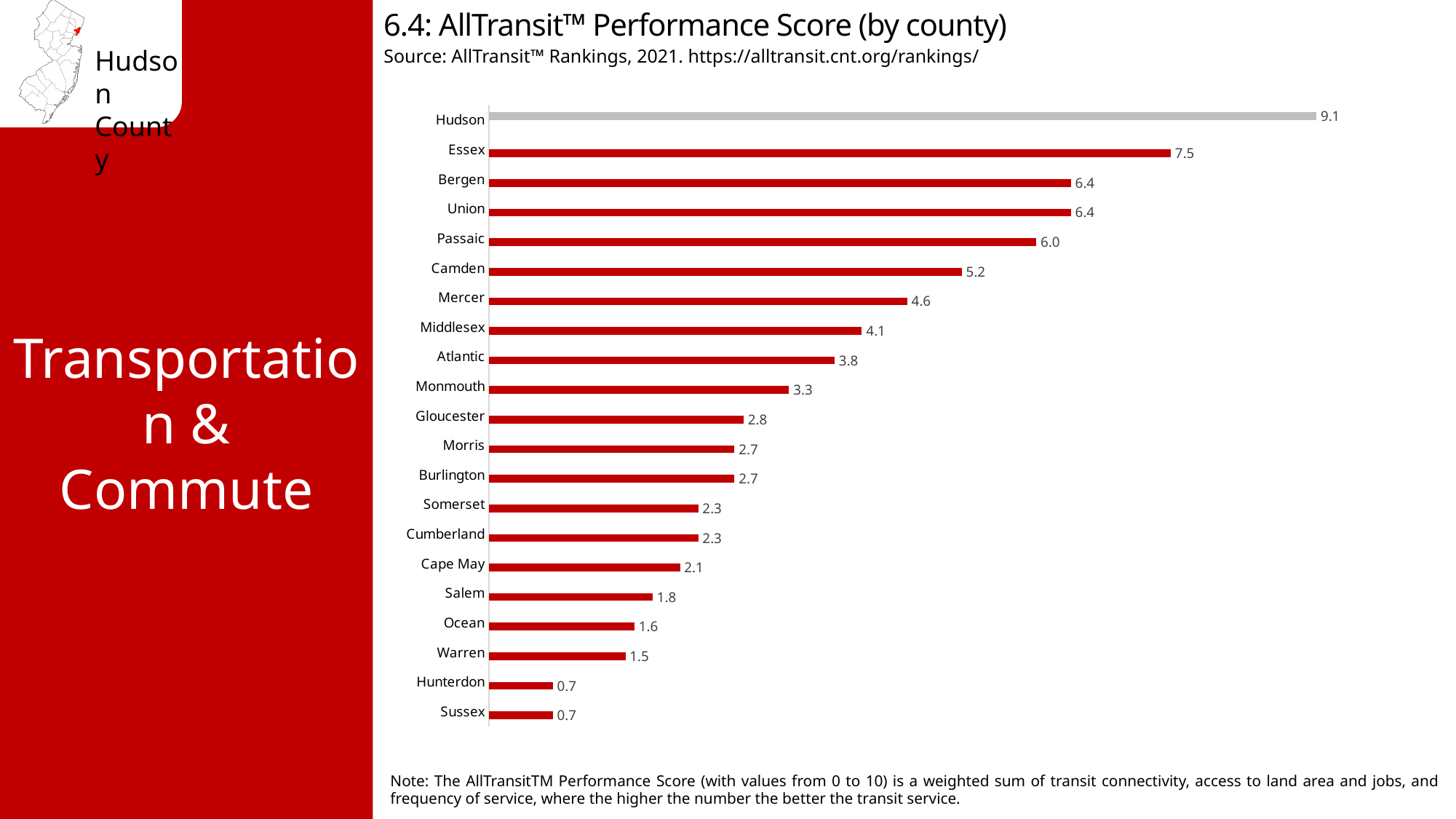
What is the AllTransit Performance Score for Hudson County? 9.1 What is the AllTransit Performance Score for Essex County? 7.5 What is the difference between the AllTransit Performance Scores of Hudson and Essex counties? 1.6 Which county has a higher AllTransit Performance Score, Middlesex or Atlantic? Middlesex Which county's bar is shown in a different colour (grey) from the others? Hudson Which county has the highest AllTransit Performance Score? Hudson Which county has a higher AllTransit Performance Score, Ocean or Warren? Ocean What is the AllTransit Performance Score for Cape May County? 2.1 What is the AllTransit Performance Score for Mercer County? 4.6 How many counties are shown in the chart? 21 What is the difference between the AllTransit Performance Scores of Passaic and Camden counties? 0.8 What kind of chart is used to show the AllTransit Performance Score by county? Bar chart